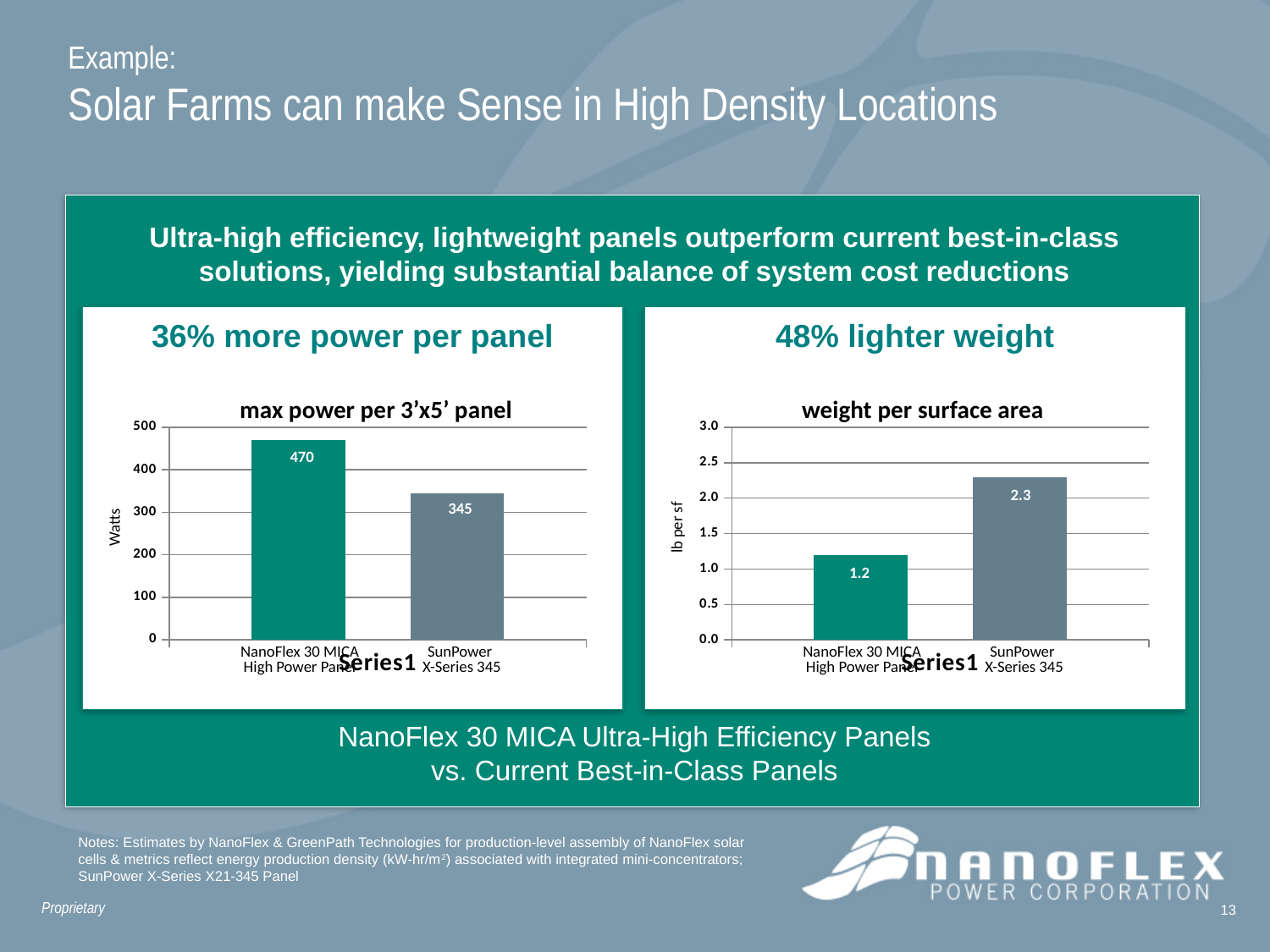
In the 'weight per surface area' chart, what is the value for SunPower X-Series 345? 2.3 In the 'weight per surface area' chart, what is the difference between the SunPower X-Series 345 and NanoFlex 30 MICA High Power Panel values? 1.1 In the 'max power per 3'x5' panel' chart, which panel has the highest value? NanoFlex 30 MICA High Power Panel In the 'weight per surface area' chart, which is larger: the value for SunPower X-Series 345 or NanoFlex 30 MICA High Power Panel? SunPower X-Series 345 In the 'max power per 3'x5' panel' chart, what is the difference between the NanoFlex 30 MICA High Power Panel and SunPower X-Series 345 values? 125 In the 'max power per 3'x5' panel' chart, what is the value for SunPower X-Series 345? 345 In the 'weight per surface area' chart, what is the value for NanoFlex 30 MICA High Power Panel? 1.2 In the 'weight per surface area' chart, which panel has the lowest value? NanoFlex 30 MICA High Power Panel What kind of chart is the 'weight per surface area' chart? Bar chart What is the y-axis label of the 'max power per 3'x5' panel' chart? Watts How many categories are shown in the 'max power per 3'x5' panel' chart? 2 In the 'max power per 3'x5' panel' chart, what is the value for NanoFlex 30 MICA High Power Panel? 470